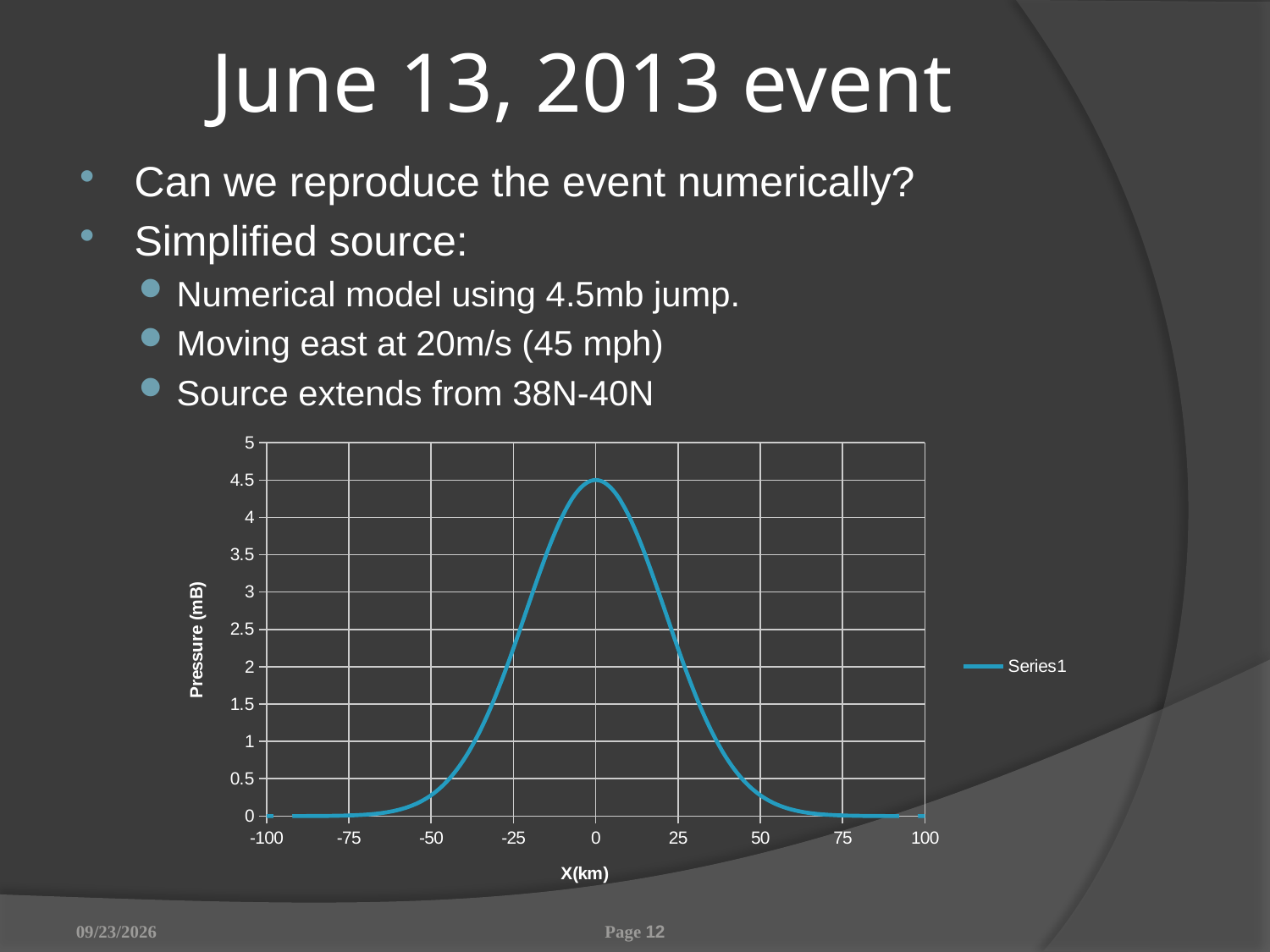
Is the pressure at X = 75 km greater or less than 0.5? less What is the name of the series shown in the legend? Series1 Does the pressure rise or fall as X goes from -100 km to 0 km? rise What is the peak pressure value reached by the curve at X = 0 km? 4.5 What kind of chart is shown on the slide? line chart How many series does the legend list? 1 Does the pressure rise or fall as X goes from 0 km to 100 km? fall Is the pressure at X = 25 km greater or less than 1.5? greater Is the pressure at X = -50 km greater or less than 0.5? less What is the title of the x axis? X(km) At which value of X(km) does the pressure reach its maximum? 0 Which is larger, the pressure at X = 0 km or the pressure at X = 50 km? X = 0 km